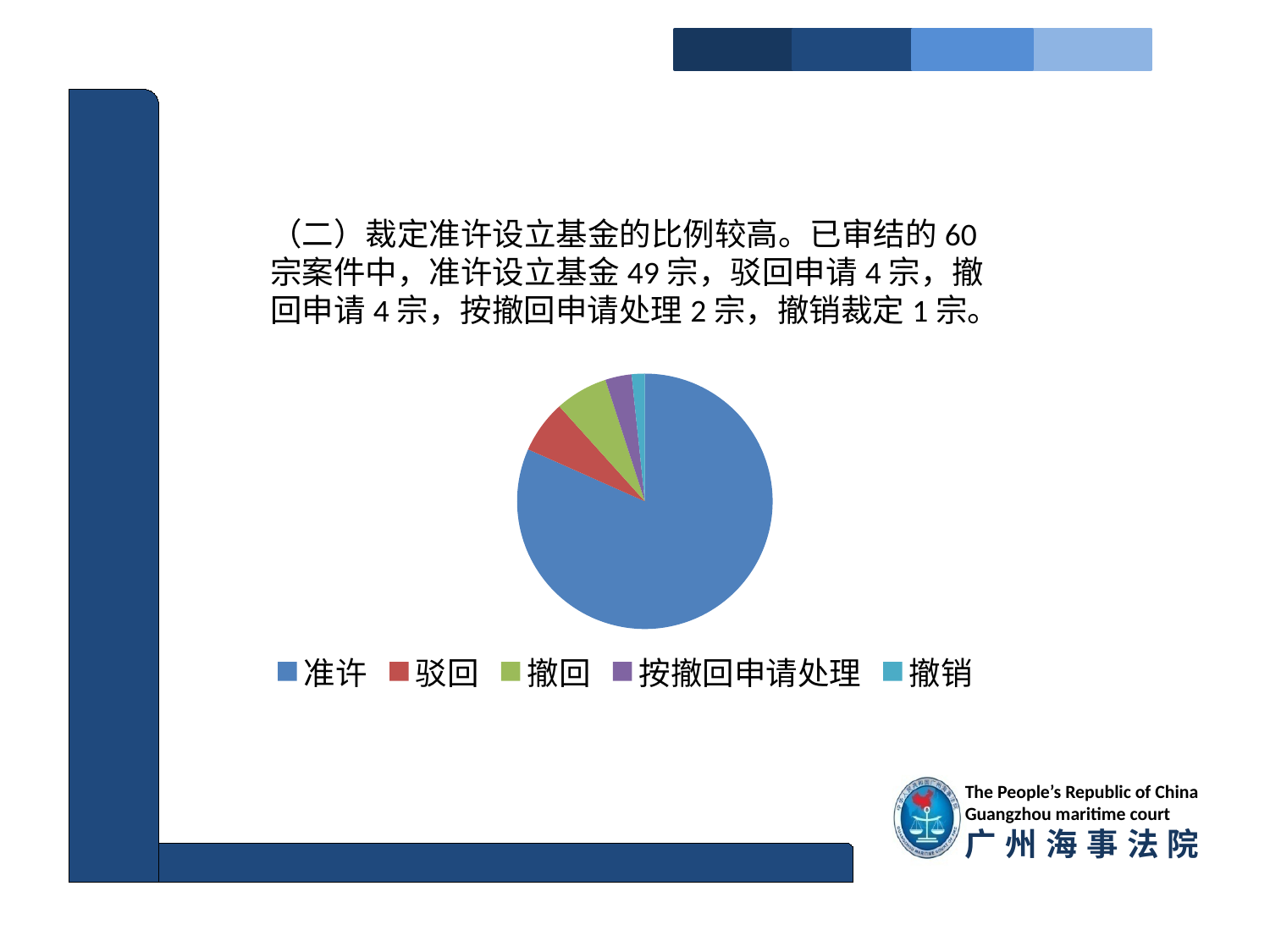
According to the slide text, how many cases in total were 已审结? 60 宗 What is the difference between the number of 准许 cases and 驳回 cases stated on the slide? 45 How many categories does the pie chart's legend list? 5 Which category has the smallest slice of the pie chart? 撤销 What kind of chart is shown on the slide? pie chart Which slice is larger, 撤回 or 撤销? 撤回 According to the slide text, how many cases were 准许设立基金? 49 宗 Which category has the largest slice of the pie chart? 准许 According to the slide text, how many cases were 驳回申请? 4 宗 According to the slide text, how many cases were 按撤回申请处理? 2 宗 Which slice is larger, 准许 or 驳回? 准许 What colour is the 准许 slice in the pie chart? blue